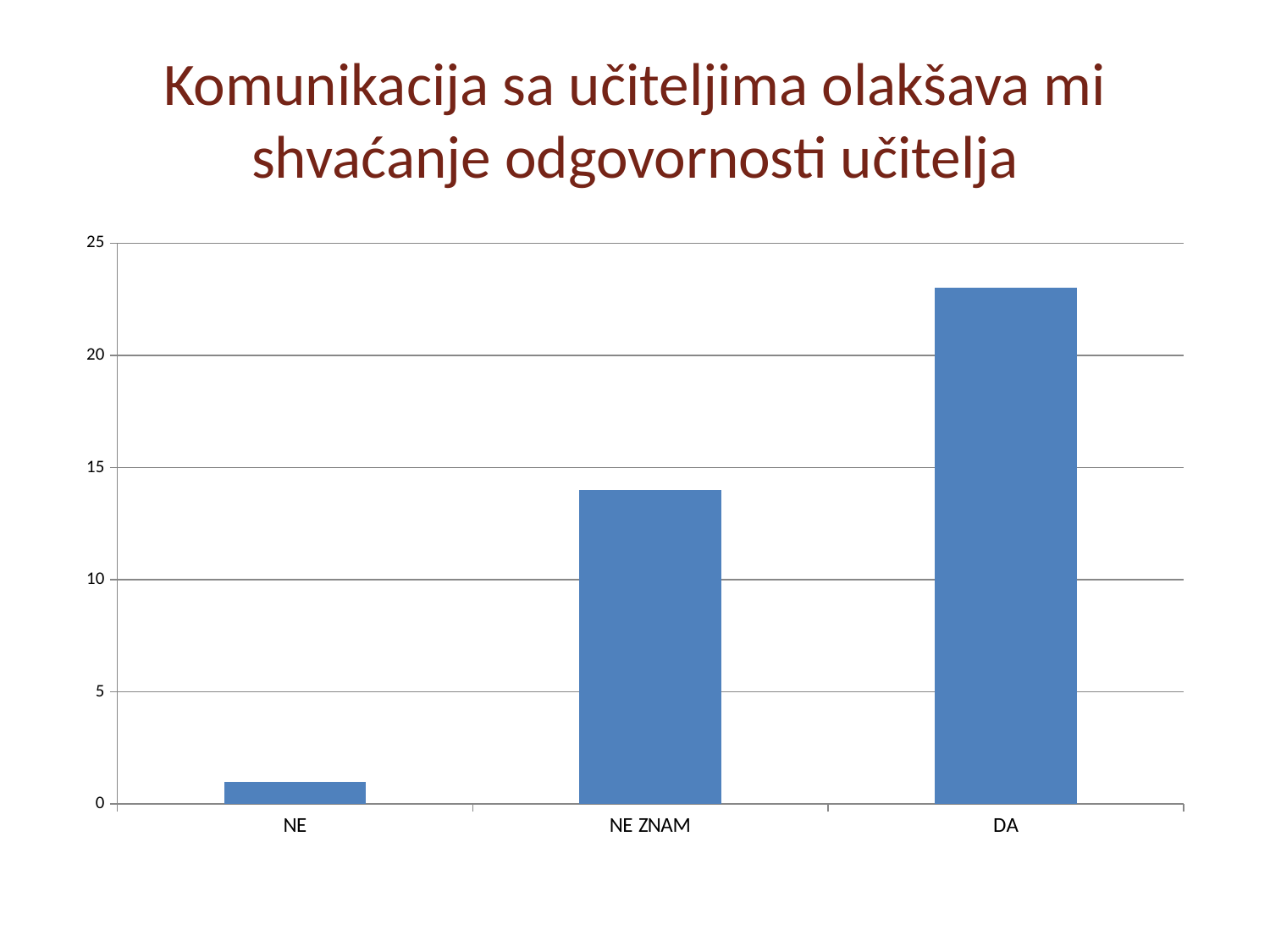
Which category has the lowest bar? NE Is the value for NE greater or less than 5? less Is the value for DA greater or less than 25? less What kind of chart is shown on the slide? bar chart Which is larger, the value for NE ZNAM or the value for DA? DA Which category has the highest bar? DA Is the value for NE ZNAM greater or less than 15? less How many categories are shown on the x axis of the chart? 3 Do the bar values rise or fall from left to right along the x axis? rise What is the title of the slide containing the chart? Komunikacija sa učiteljima olakšava mi shvaćanje odgovornosti učitelja